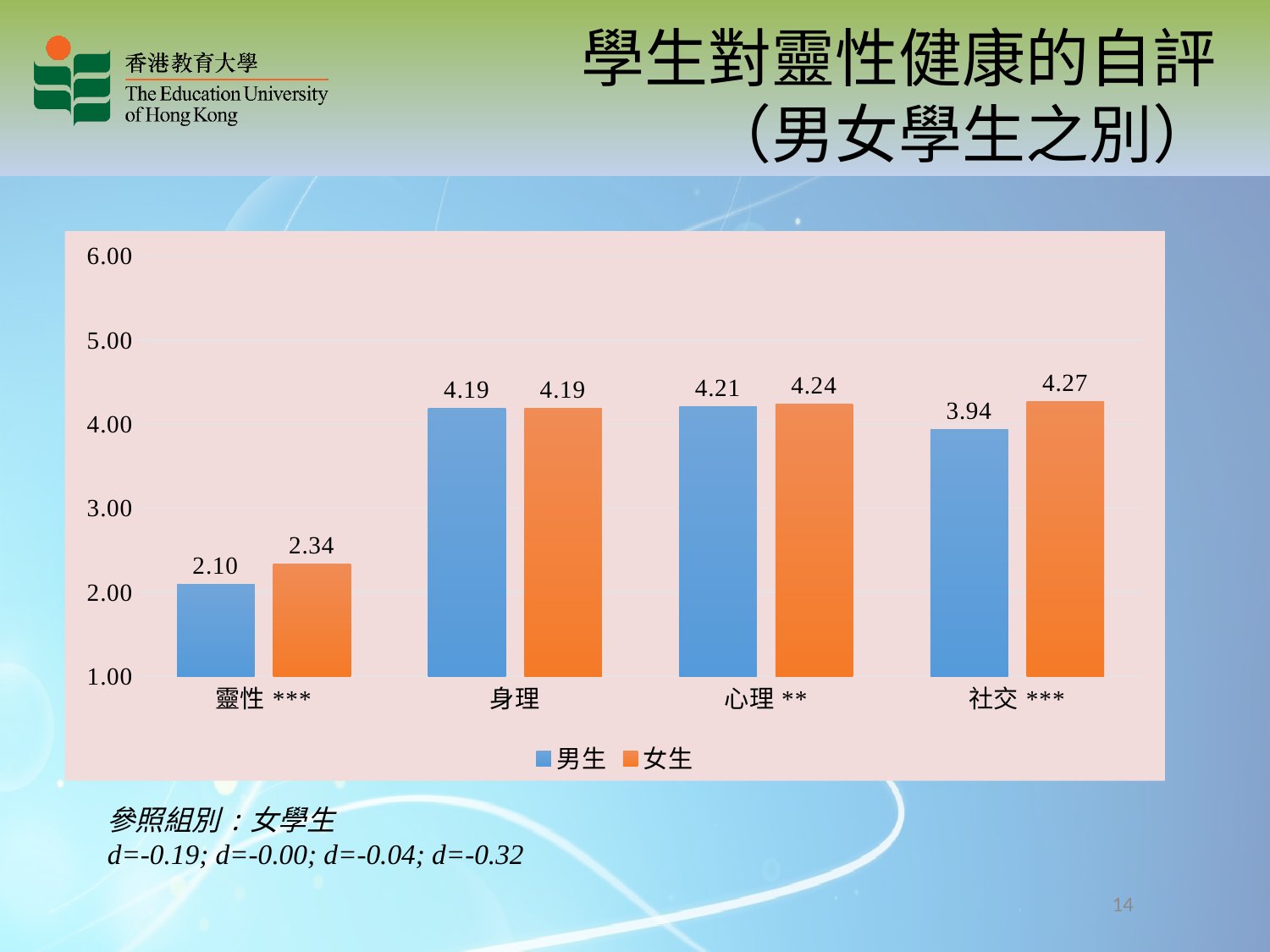
Which category has the lowest value for 女生? 靈性 *** What is the difference between the 女生 and 男生 values in the 靈性 *** category? 0.24 What is the value for 男生 in the 靈性 *** category? 2.10 Which category has the highest value for 女生? 社交 *** What is the difference between the 女生 and 男生 values in the 社交 *** category? 0.33 What is the value for 男生 in the 心理 ** category? 4.21 What kind of chart is shown on the slide? bar chart Which colour represents 女生 in the chart? orange How many series does the legend list? 2 What is the value for 女生 in the 社交 *** category? 4.27 How many categories are shown on the x axis? 4 Which is larger in the 社交 *** category, the 男生 value or the 女生 value? 女生